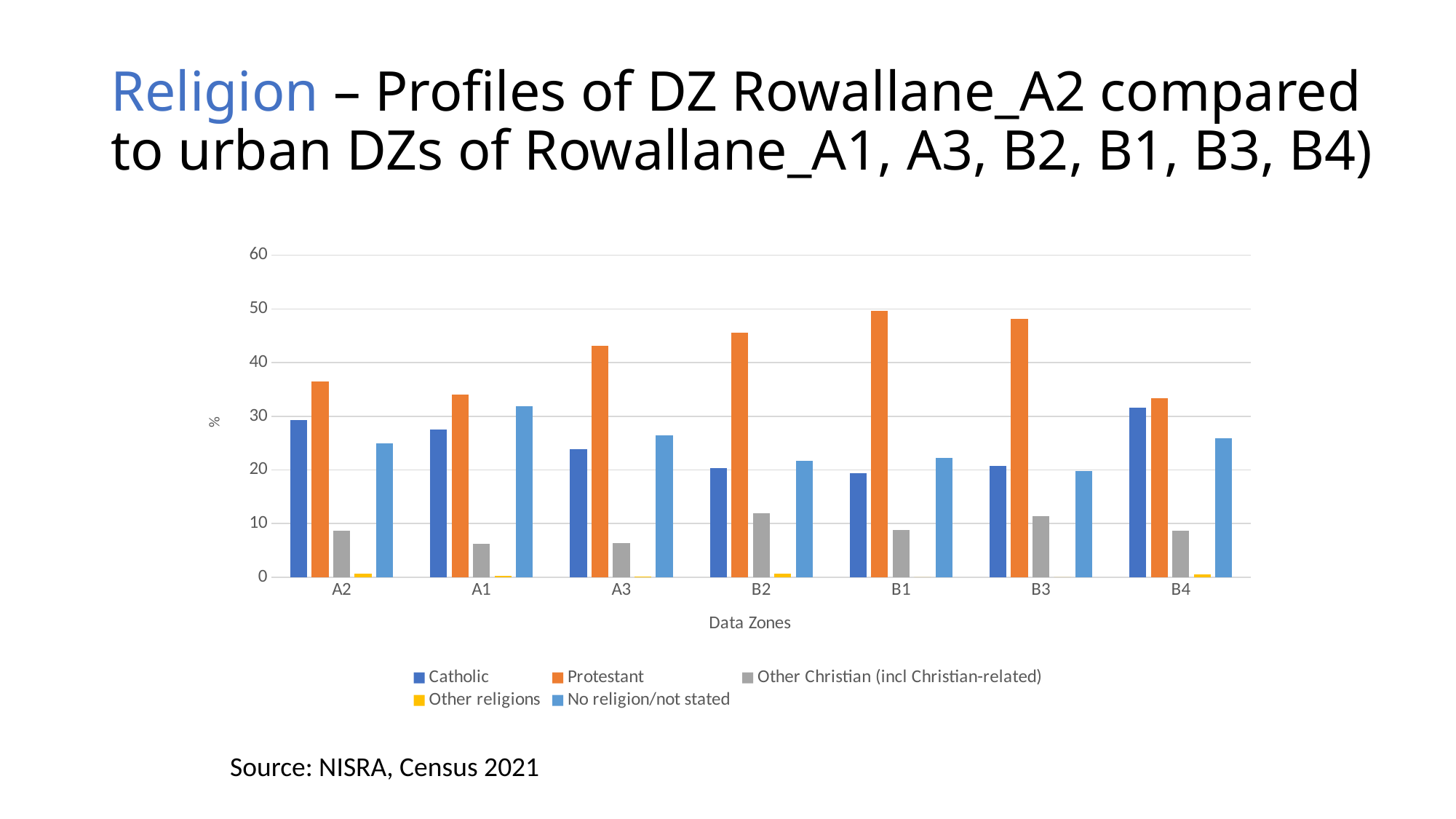
Which data zone has the highest No religion/not stated value? A1 Is the Other Christian (incl Christian-related) value for B2 greater or less than 10? greater What is the title of the x axis of the chart? Data Zones Is the Protestant value for A1 greater or less than 40? less In data zone A2, which is larger: the Catholic value or the Protestant value? Protestant Is the Catholic value for A2 greater or less than 20? greater Which data zone has the highest Catholic value? B4 What kind of chart is shown on the slide? Bar chart Which data zone has the highest Protestant value? B1 How many series does the chart's legend list? 5 How many data zones are shown on the x axis of the chart? 7